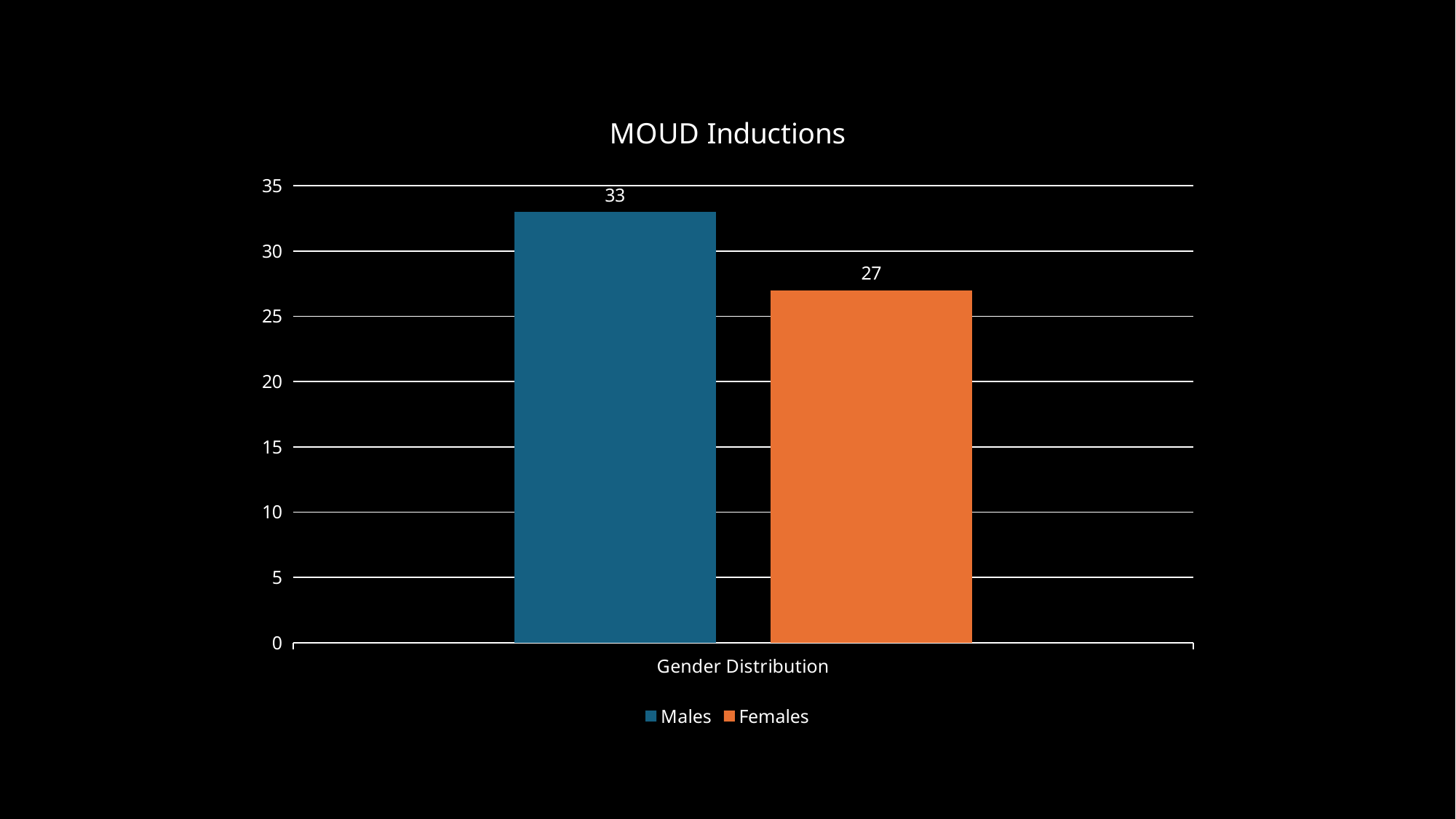
What is the title of the chart on the slide? MOUD Inductions What kind of chart is shown on the slide? Bar chart What is the value for Males in the MOUD Inductions chart? 33 What is the value for Females in the MOUD Inductions chart? 27 Which series has the highest value in the MOUD Inductions chart? Males What is the x-axis category label in the MOUD Inductions chart? Gender Distribution Is the value for Females greater or less than 30 in the MOUD Inductions chart? less Which is larger in the MOUD Inductions chart, the value for Males or the value for Females? Males How many series does the legend list in the MOUD Inductions chart? 2 What is the difference between the Males and Females values in the MOUD Inductions chart? 6 Is the value for Males greater or less than 30 in the MOUD Inductions chart? greater Which series has the lowest value in the MOUD Inductions chart? Females